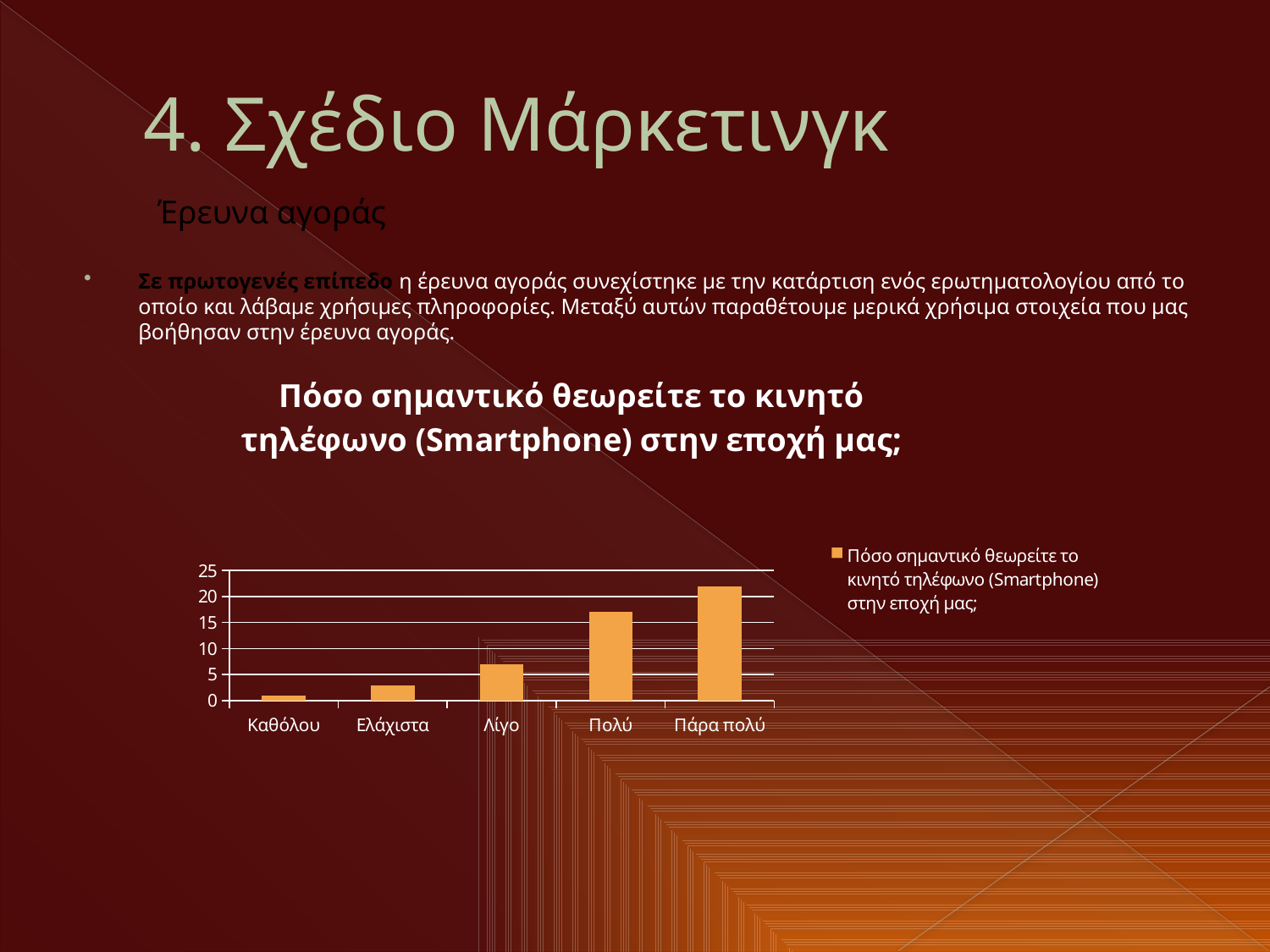
How many series does the chart legend list? 1 Which is larger, the value for Πολύ or the value for Λίγο? Πολύ Is the value for Ελάχιστα greater or less than 5? less What is the title of the chart? Πόσο σημαντικό θεωρείτε το κινητό τηλέφωνο (Smartphone) στην εποχή μας; How many categories are shown on the x axis of the chart? 5 Which category has the lowest bar in the chart? Καθόλου Do the bar values rise or fall from Καθόλου to Πάρα πολύ along the x axis? rise What kind of chart is shown on the slide? bar chart Which category has the highest bar in the chart? Πάρα πολύ Which is larger, the value for Ελάχιστα or the value for Πάρα πολύ? Πάρα πολύ Is the value for Πολύ greater or less than 15? greater Is the value for Πάρα πολύ greater or less than 20? greater